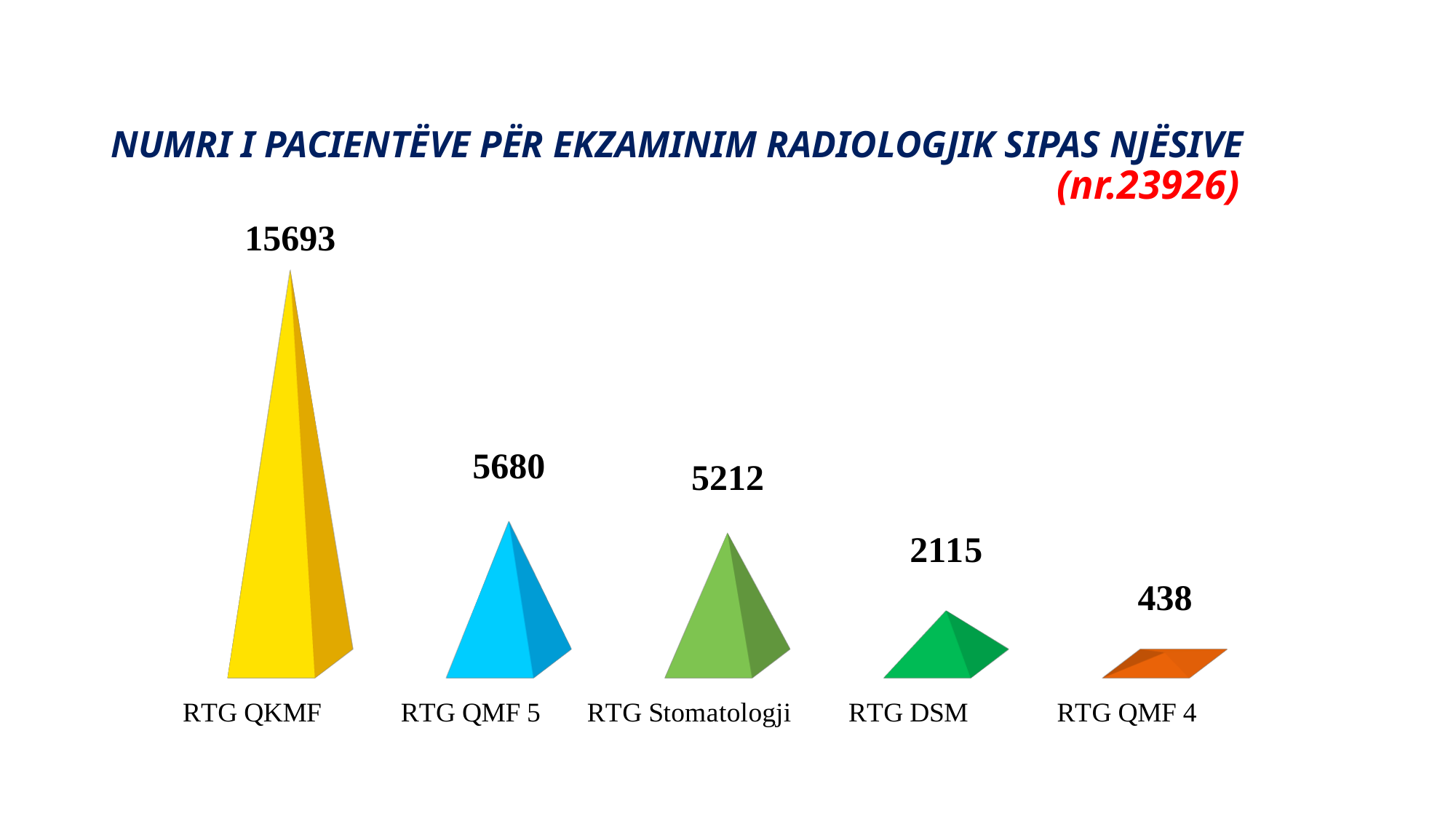
How many categories are shown in the chart? 5 Which category has the highest value? RTG QKMF Which is larger, the value for RTG QMF 5 or RTG Stomatologji? RTG QMF 5 What kind of chart is shown on the slide? Bar chart What is the value for RTG QMF 5? 5680 What is the difference between the values for RTG QKMF and RTG QMF 5? 10013 What is the value for RTG QKMF? 15693 What is the value for RTG QMF 4? 438 What is the value for RTG DSM? 2115 Which category has the lowest value? RTG QMF 4 What is the value for RTG Stomatologji? 5212 What is the difference between the values for RTG DSM and RTG QMF 4? 1677